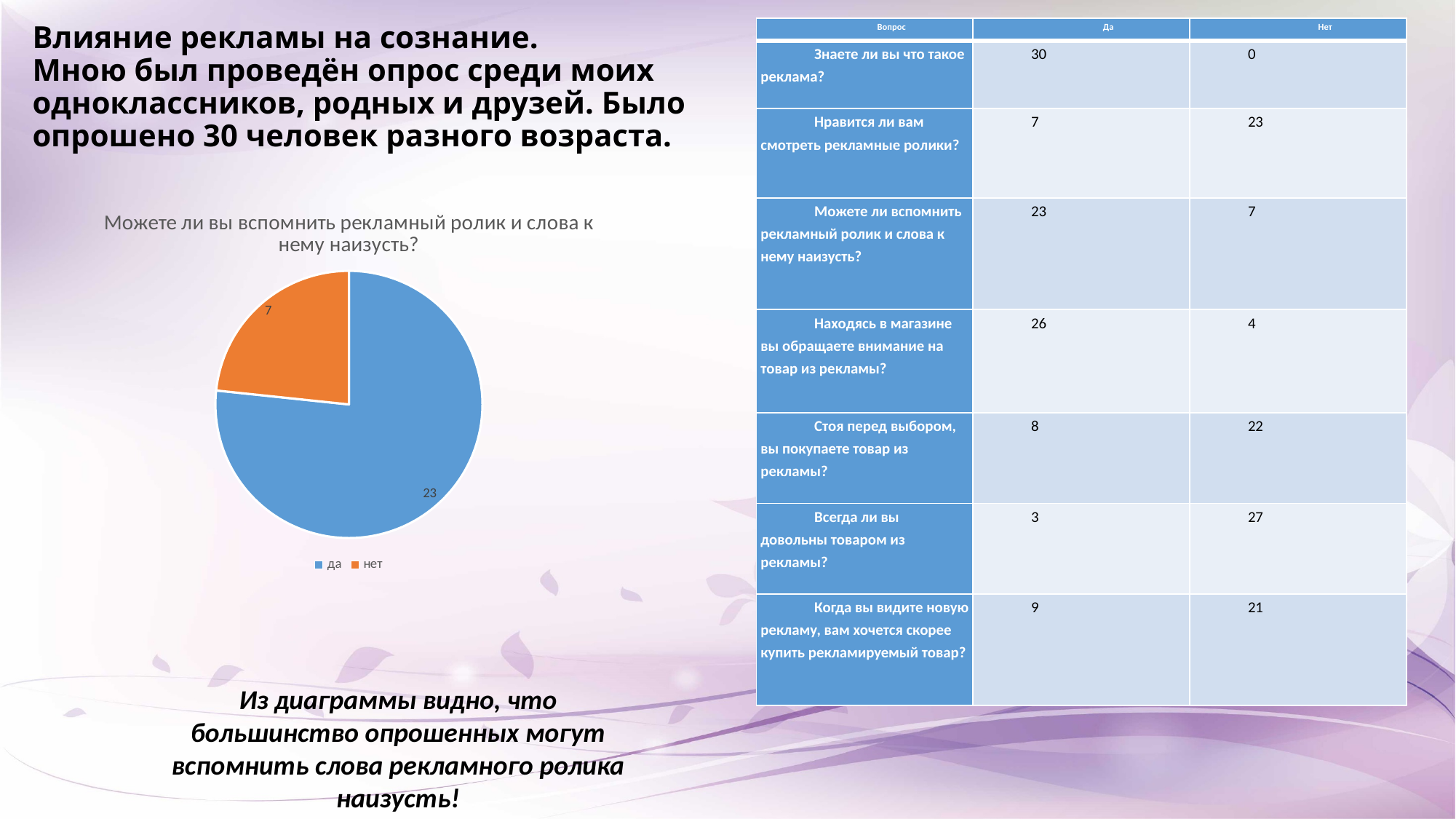
What is the title of the pie chart? Можете ли вы вспомнить рекламный ролик и слова к нему наизусть? Which category has the smallest slice in the pie chart? нет How many slices does the pie chart have? 2 What type of chart is shown on the slide? pie chart Which is larger in the pie chart, 'да' or 'нет'? да What is the total of all slices in the pie chart? 30 What is the value of the 'нет' slice in the pie chart? 7 Which category has the largest slice in the pie chart? да What is the value of the 'да' slice in the pie chart? 23 What is the difference between the 'да' and 'нет' values in the pie chart? 16 How many entries does the legend of the pie chart list? 2 What colour is the 'нет' slice in the pie chart? orange